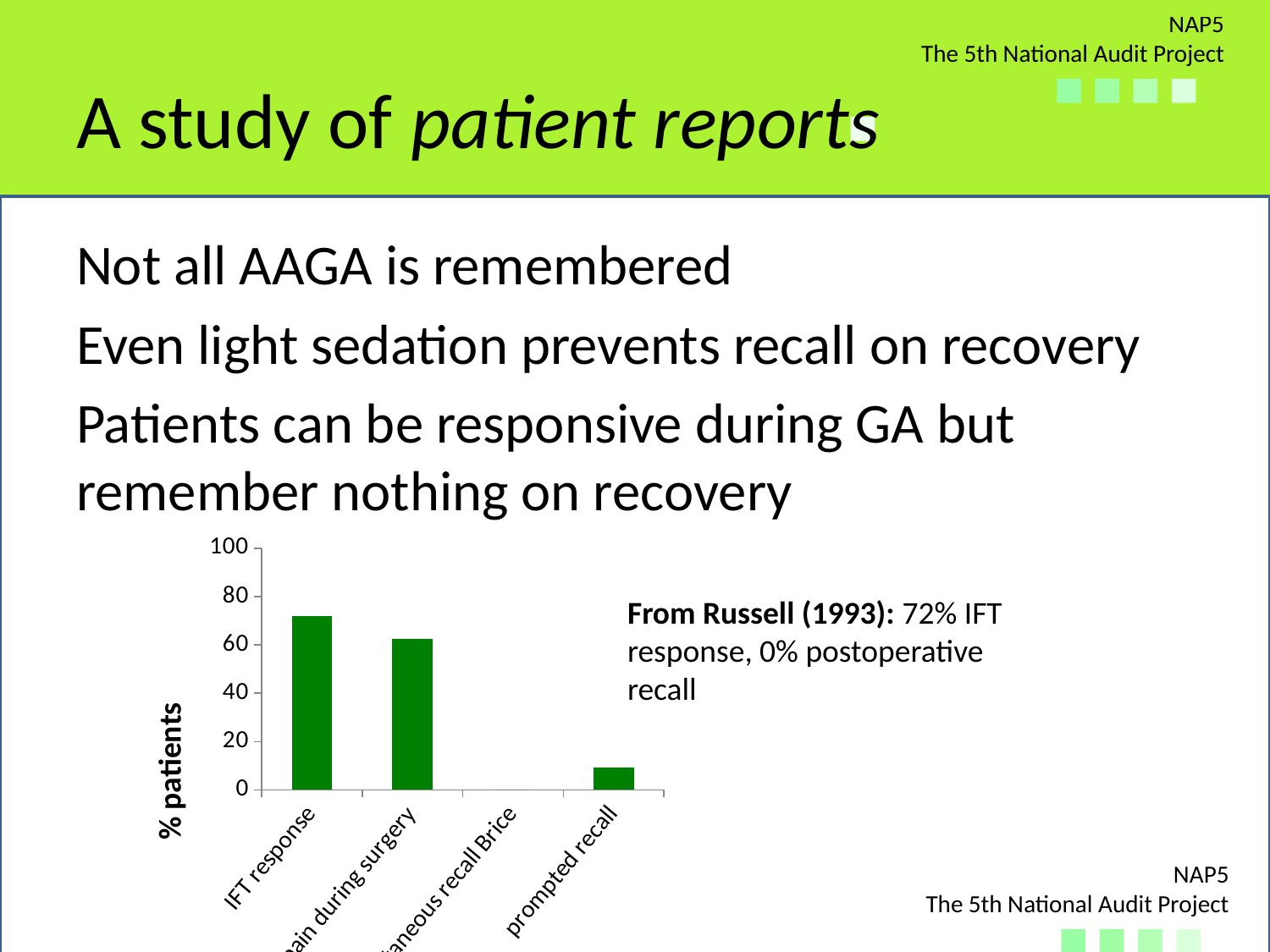
Which is larger, the value for IFT response or the value for prompted recall? IFT response How many categories are shown on the x axis of the chart? 4 Which category has the highest value in the chart? IFT response What type of chart is shown on the slide? bar chart How many categories in the chart have a visible bar? 3 What is the label on the y axis of the chart? % patients Is the value for IFT response greater or less than 60? greater What is the highest tick value shown on the y axis? 100 Is the value for IFT response greater or less than 80? less Is the value for prompted recall greater or less than 20? less